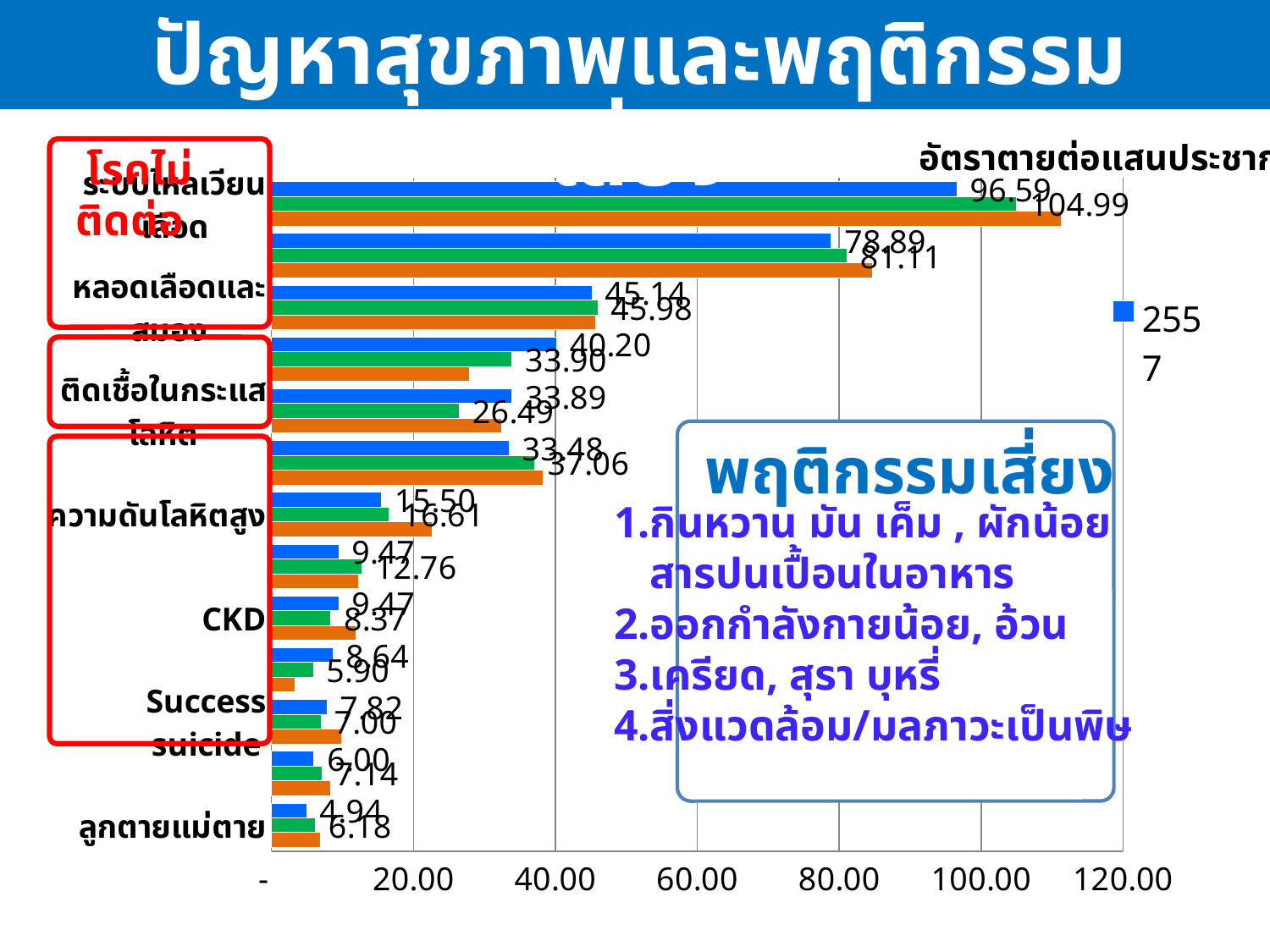
What type of chart is shown on the slide? bar chart How many bars are plotted for each category? 3 What is the value of the green bar for ระบบไหลเวียนเลือด? 104.99 What is the value of the blue (2557) bar for หลอดเลือดและสมอง? 45.14 Which category has the highest death rate in the chart? ระบบไหลเวียนเลือด Which labelled category has the lowest blue (2557) value? ลูกตายแม่ตาย What is the value of the green bar for ลูกตายแม่ตาย? 6.18 Which is larger for the blue (2557) series: ระบบไหลเวียนเลือด or หลอดเลือดและสมอง? ระบบไหลเวียนเลือด What is the value of the blue (2557) bar for ระบบไหลเวียนเลือด? 96.59 What is the difference between the green and blue values for ระบบไหลเวียนเลือด? 8.40 What year is shown in the legend next to the blue marker? 2557 Is the orange bar for ระบบไหลเวียนเลือด greater or less than 100.00? greater